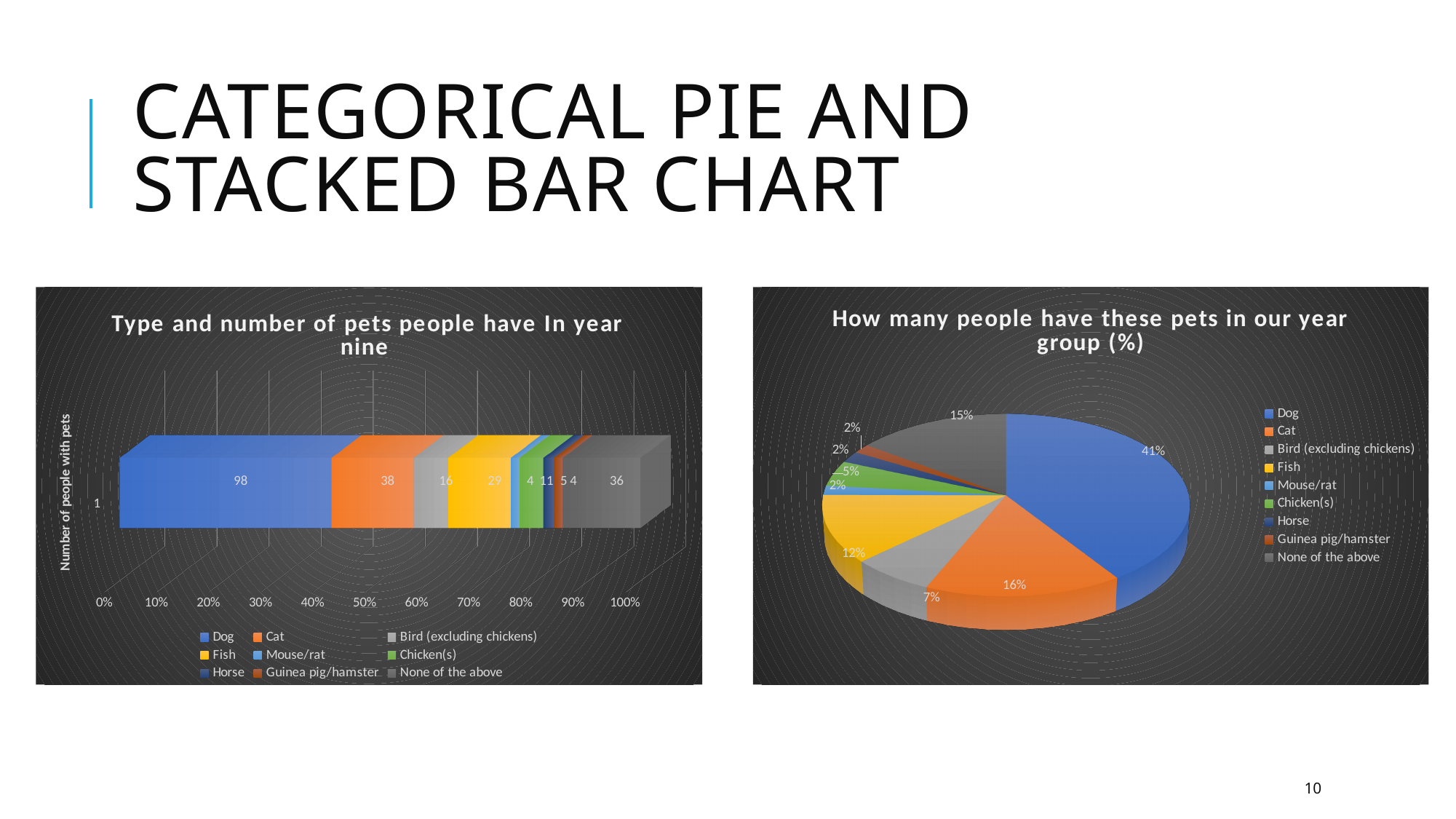
How many series does the legend of the left chart, 'Type and number of pets people have In year nine', list? 9 In the right chart, 'How many people have these pets in our year group (%)', what is the value for Fish? 12% In the left chart, 'Type and number of pets people have In year nine', what is the difference between the values for Dog and Cat? 60 In the left chart, 'Type and number of pets people have In year nine', which pet type has the highest value? Dog In the left chart, 'Type and number of pets people have In year nine', what is the value for Cat? 38 In the left chart, 'Type and number of pets people have In year nine', which is larger, the value for Fish or the value for Bird (excluding chickens)? Fish In the left chart, 'Type and number of pets people have In year nine', what is the value for Dog? 98 In the right chart, 'How many people have these pets in our year group (%)', which category has the smallest share among Cat, Bird (excluding chickens) and None of the above? Bird (excluding chickens) What kind of chart is the left chart, 'Type and number of pets people have In year nine'? Stacked bar chart In the left chart, 'Type and number of pets people have In year nine', what is the value for None of the above? 36 In the left chart, 'Type and number of pets people have In year nine', what is the total of all segments in the stacked bar? 241 In the right chart, 'How many people have these pets in our year group (%)', what share of the pie is Dog? 41%